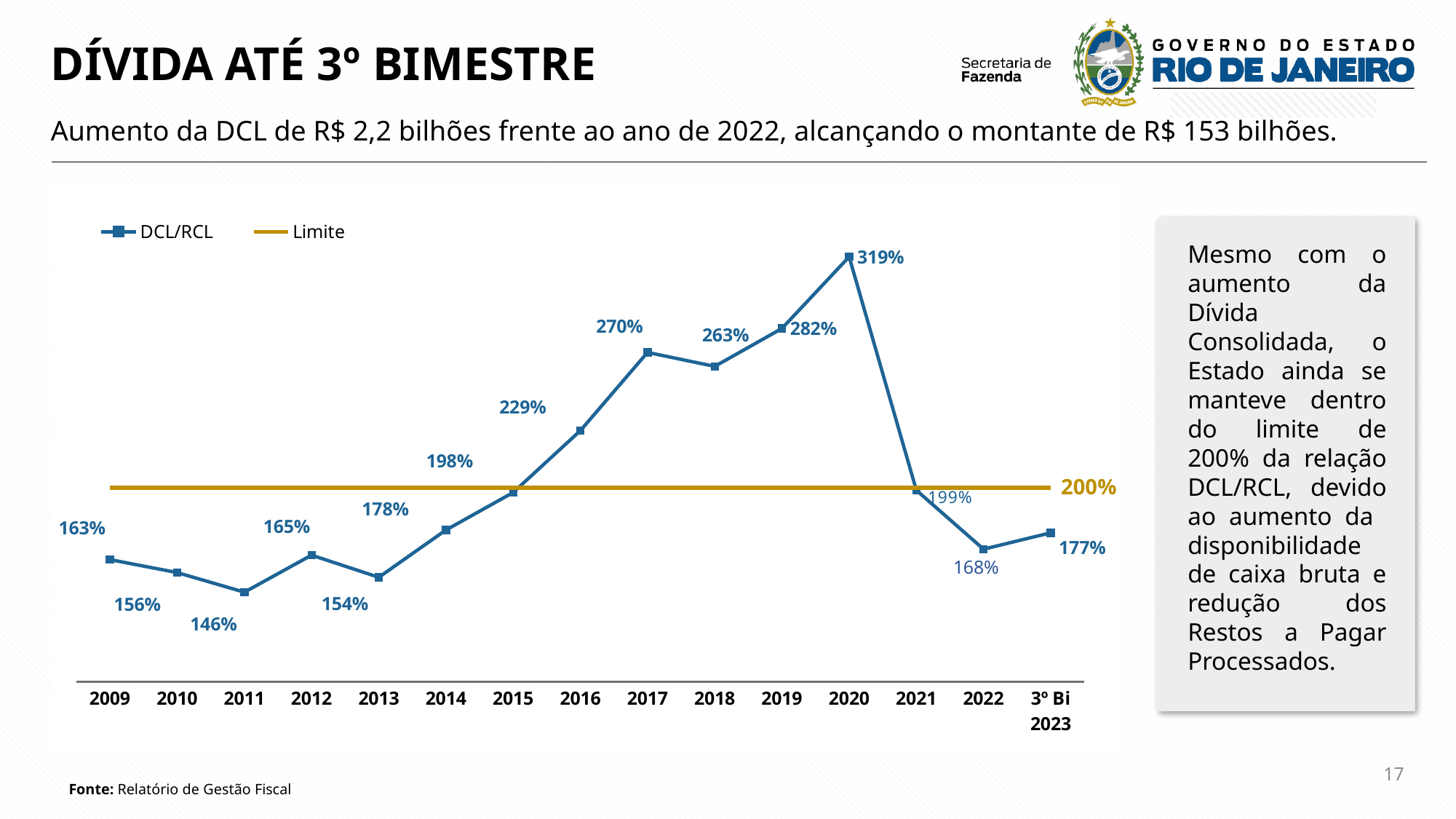
How many time periods are shown on the x axis? 15 Which year has the lowest DCL/RCL value? 2011 What is the DCL/RCL value for 2020? 319% How many series does the legend list? 2 Does the DCL/RCL value rise or fall from 2015 to 2017? Rise Which is larger, the DCL/RCL value for 2017 or for 2018? 2017 Which year has the highest DCL/RCL value? 2020 What is the DCL/RCL value for 3º Bi 2023? 177% What kind of chart is shown on the slide? Line chart What is the DCL/RCL value for 2015? 198% What is the difference between the DCL/RCL values for 2020 and 2021? 120% What value does the Limite line sit at? 200%